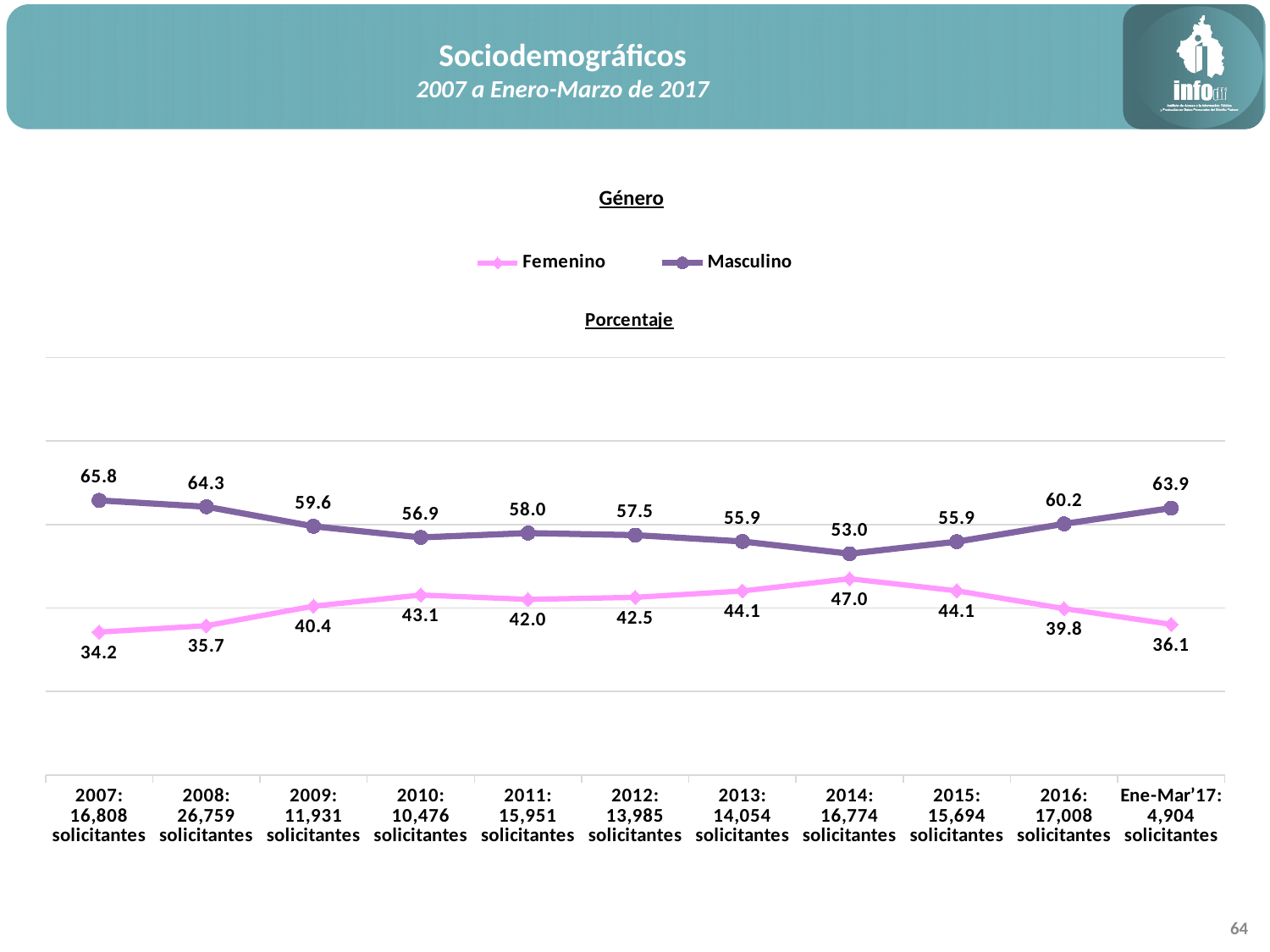
How does the Femenino percentage change from 2007 to 2014? It rises What is the Femenino percentage for Ene-Mar'17? 36.1 What type of chart is shown on the slide? line chart How many solicitantes are listed for 2016 on the x axis? 17,008 Which is larger in 2016, the Masculino or the Femenino percentage? Masculino What is the Masculino percentage for 2007? 65.8 In which year is the Masculino percentage lowest? 2014 What is the difference between the Masculino and Femenino percentages in 2007? 31.6 What is the Femenino percentage for 2014? 47.0 How many time periods are plotted on the x axis? 11 In which year is the Femenino percentage highest? 2014 How many series does the legend list? 2